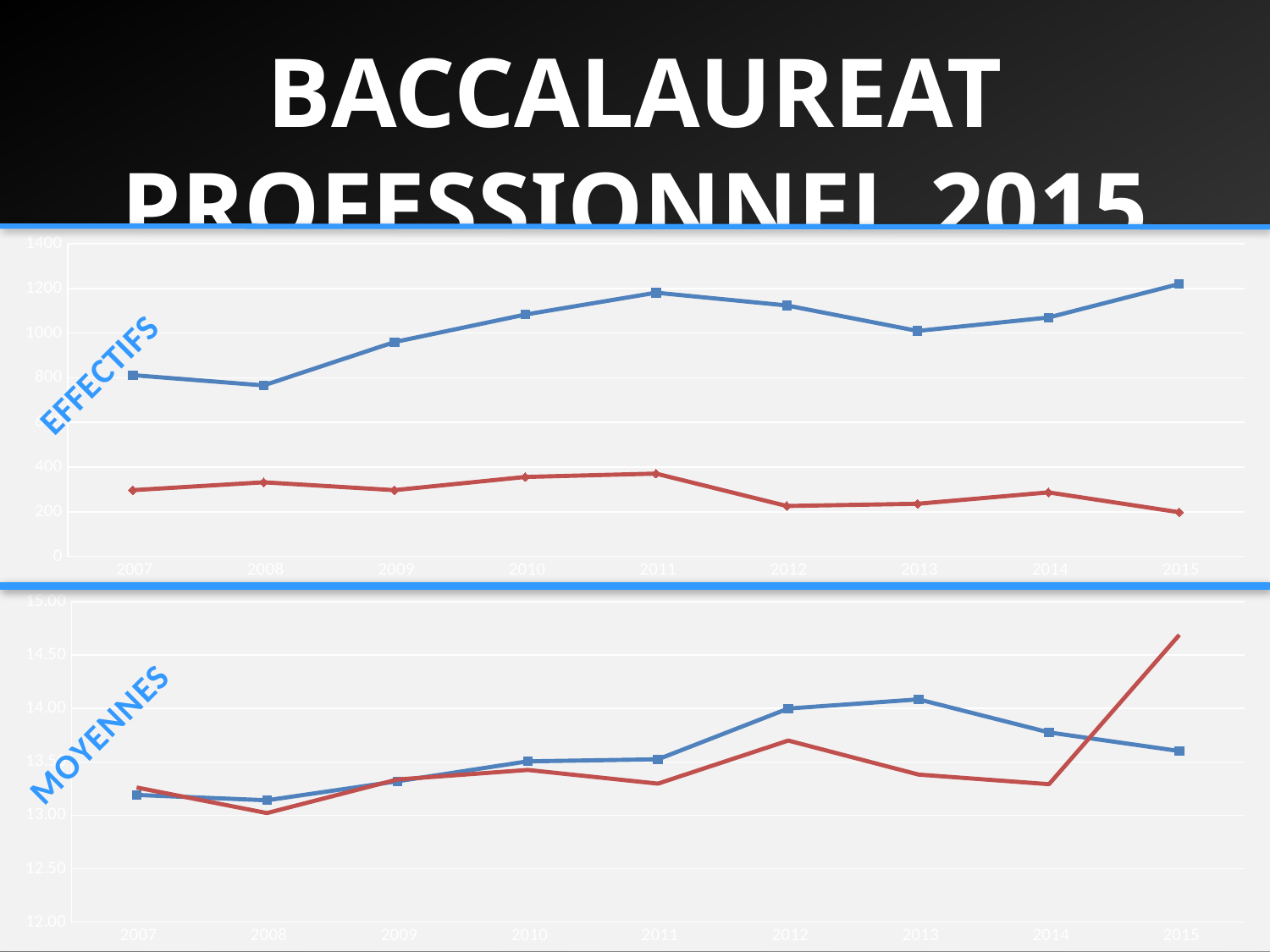
In the bottom chart (MOYENNES), which line has the higher value in 2015, the blue line or the red line? the red line In the bottom chart (MOYENNES), is the value of the blue line in 2012 greater or less than 13.50? greater In the top chart (EFFECTIFS), is the value of the blue line in 2011 greater or less than 1000? greater In the top chart (EFFECTIFS), in which year does the red line reach its lowest value? 2015 In the top chart (EFFECTIFS), in which year does the blue line reach its highest value? 2015 How many years are plotted on the x axis of the bottom chart labelled MOYENNES? 9 In the top chart (EFFECTIFS), is the value of the red line in 2011 greater or less than 400? less What kind of chart is the top chart labelled EFFECTIFS? line chart In the bottom chart (MOYENNES), in which year does the red line reach its highest value? 2015 In the top chart (EFFECTIFS), in which year does the blue line reach its lowest value? 2008 In the bottom chart (MOYENNES), in which year does the red line reach its lowest value? 2008